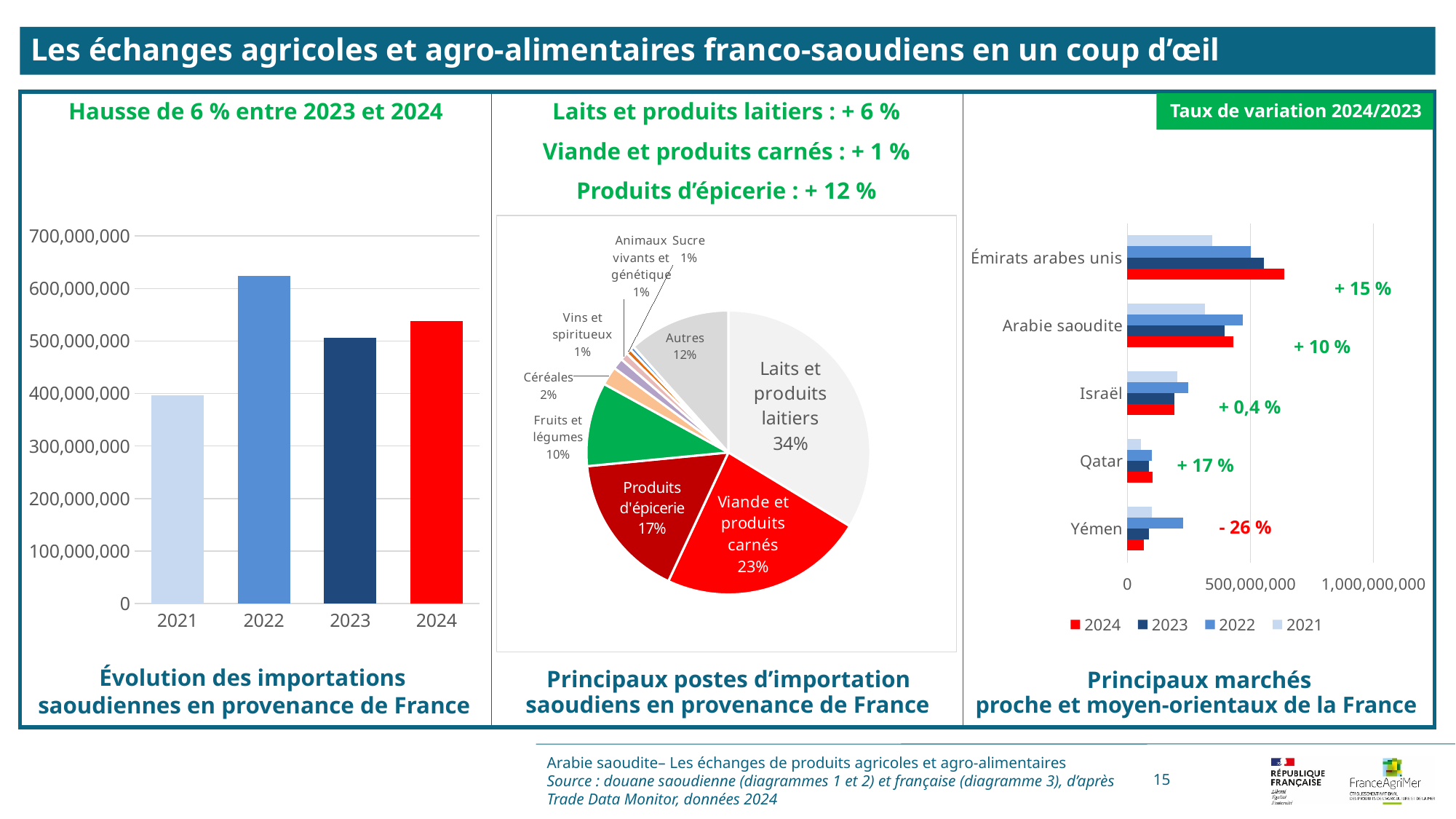
On the left chart 'Évolution des importations saoudiennes en provenance de France', is the value for 2022 greater or less than 600,000,000? greater On the middle pie chart 'Principaux postes d'importation saoudiens en provenance de France', what is the difference in percentage points between 'Laits et produits laitiers' and 'Viande et produits carnés'? 11 percentage points On the right chart 'Principaux marchés proche et moyen-orientaux de la France', how many series does the legend list? 4 On the middle pie chart 'Principaux postes d'importation saoudiens en provenance de France', what share is 'Fruits et légumes'? 10% On the right chart 'Principaux marchés proche et moyen-orientaux de la France', is the 2024 value for Émirats arabes unis greater or less than 500,000,000? greater On the left chart 'Évolution des importations saoudiennes en provenance de France', which is larger, the value for 2023 or the value for 2024? 2024 On the middle pie chart 'Principaux postes d'importation saoudiens en provenance de France', what share is 'Laits et produits laitiers'? 34% On the left chart 'Évolution des importations saoudiennes en provenance de France', which year has the highest value? 2022 On the left chart 'Évolution des importations saoudiennes en provenance de France', which year has the lowest value? 2021 On the middle pie chart 'Principaux postes d'importation saoudiens en provenance de France', how many slices are there? 9 On the left chart 'Évolution des importations saoudiennes en provenance de France', what kind of chart is shown? bar chart On the right chart 'Principaux marchés proche et moyen-orientaux de la France', what is the 'Taux de variation 2024/2023' shown for Yémen? - 26 %